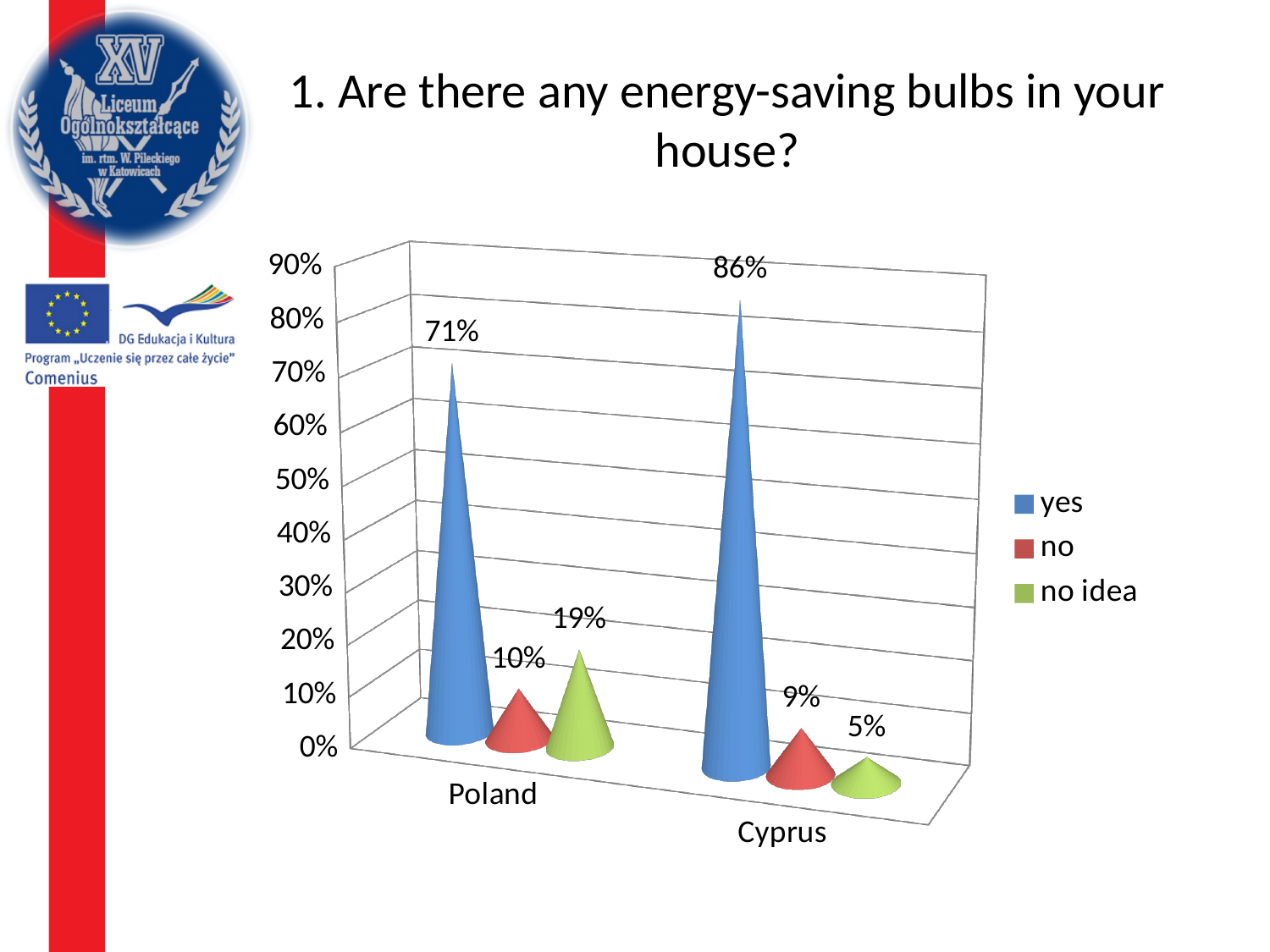
What is the difference between the "yes" values for Cyprus and Poland? 15% How many countries are shown on the x axis? 2 Is the "no idea" value for Poland larger than the "no" value for Poland? Yes What percentage of respondents in Poland answered "yes"? 71% What is the difference between the "no idea" values for Poland and Cyprus? 14% How many series does the legend list? 3 What percentage of respondents in Cyprus answered "no"? 9% What colour represents the "no" series in the legend? Red What percentage of respondents in Cyprus answered "no idea"? 5% Which country has the higher "yes" value? Cyprus Which answer has the lowest value for Cyprus? no idea What kind of chart is shown on the slide? Bar chart